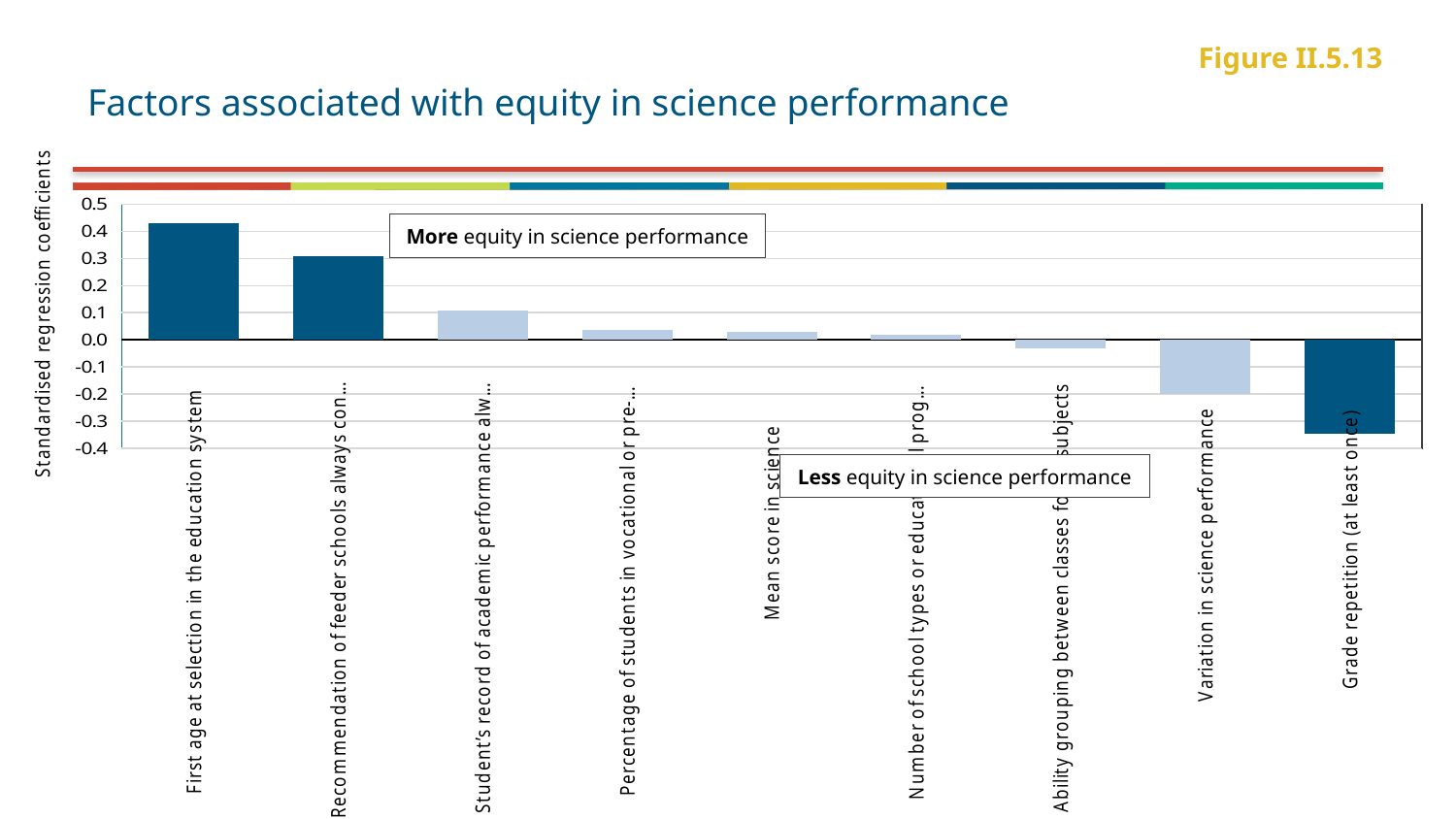
How many factors (bars) are plotted in the chart? 9 Which factor has the lowest standardised regression coefficient? Grade repetition (at least once) Is the coefficient for 'First age at selection in the education system' greater or less than 0.4? greater Is the coefficient for 'Mean score in science' greater or less than 0.1? less Is the coefficient for 'Variation in science performance' greater or less than -0.1? less How many bars in the chart have negative coefficients? 3 Which has the larger coefficient: 'First age at selection in the education system' or 'Recommendation of feeder schools'? First age at selection in the education system What kind of chart is shown on the slide? Bar chart What is the title of the chart? Factors associated with equity in science performance What is the label on the vertical axis of the chart? Standardised regression coefficients Which factor has the highest standardised regression coefficient? First age at selection in the education system